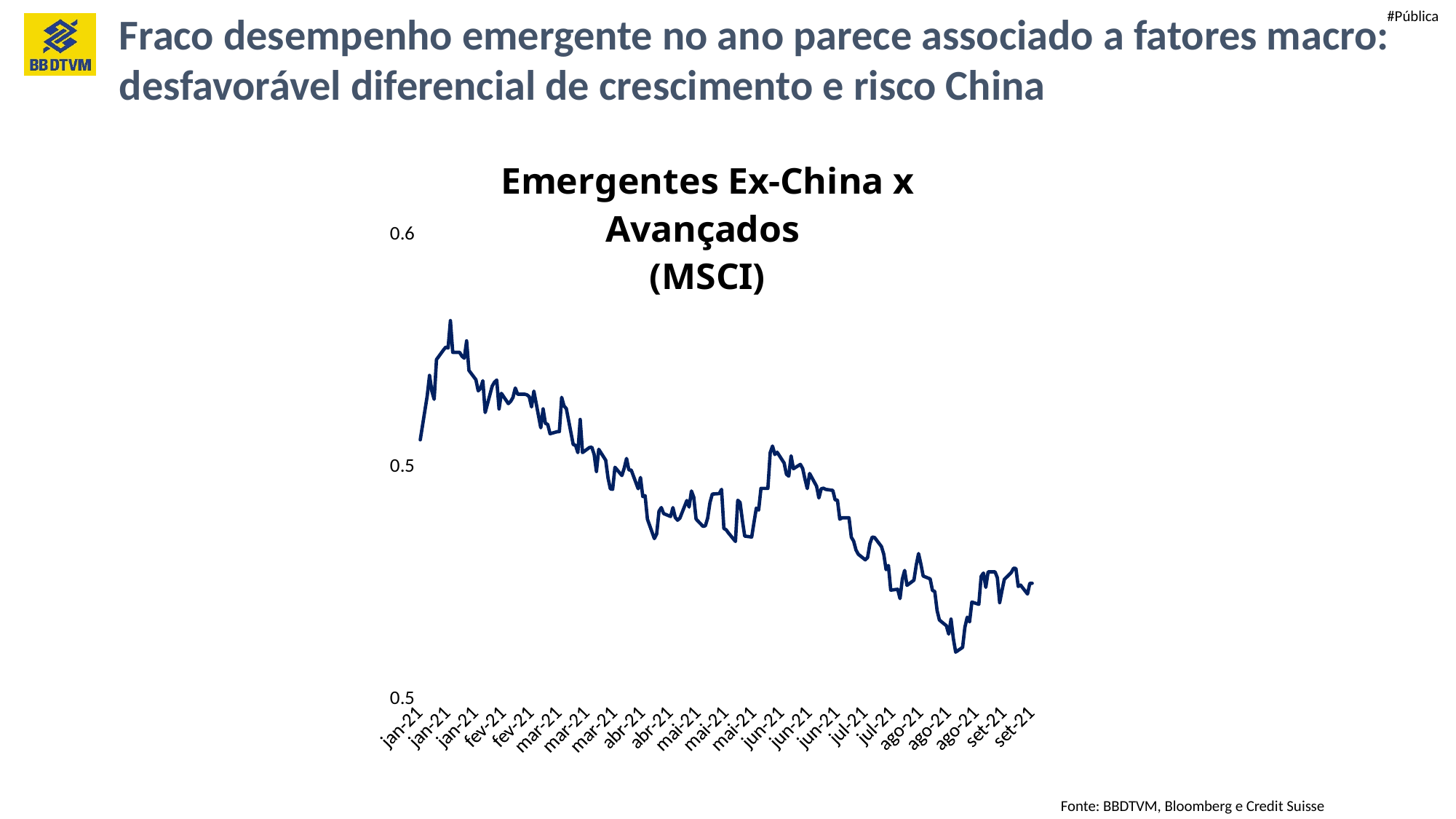
What is the source cited for the chart? BBDTVM, Bloomberg e Credit Suisse Overall, does the line rise or fall from jan-21 to set-21? fall What is the title of the chart? Emergentes Ex-China x Avançados (MSCI) In which month does the line reach its highest point? jan-21 Is the value in fev-21 greater or less than 0.5? greater Is the value at the end of the series (set-21) greater or less than 0.5? less What kind of chart is shown on the slide? line chart Is the value in ago-21 greater or less than 0.5? less In which month does the line reach its lowest point? ago-21 How many lines are plotted on the chart? 1